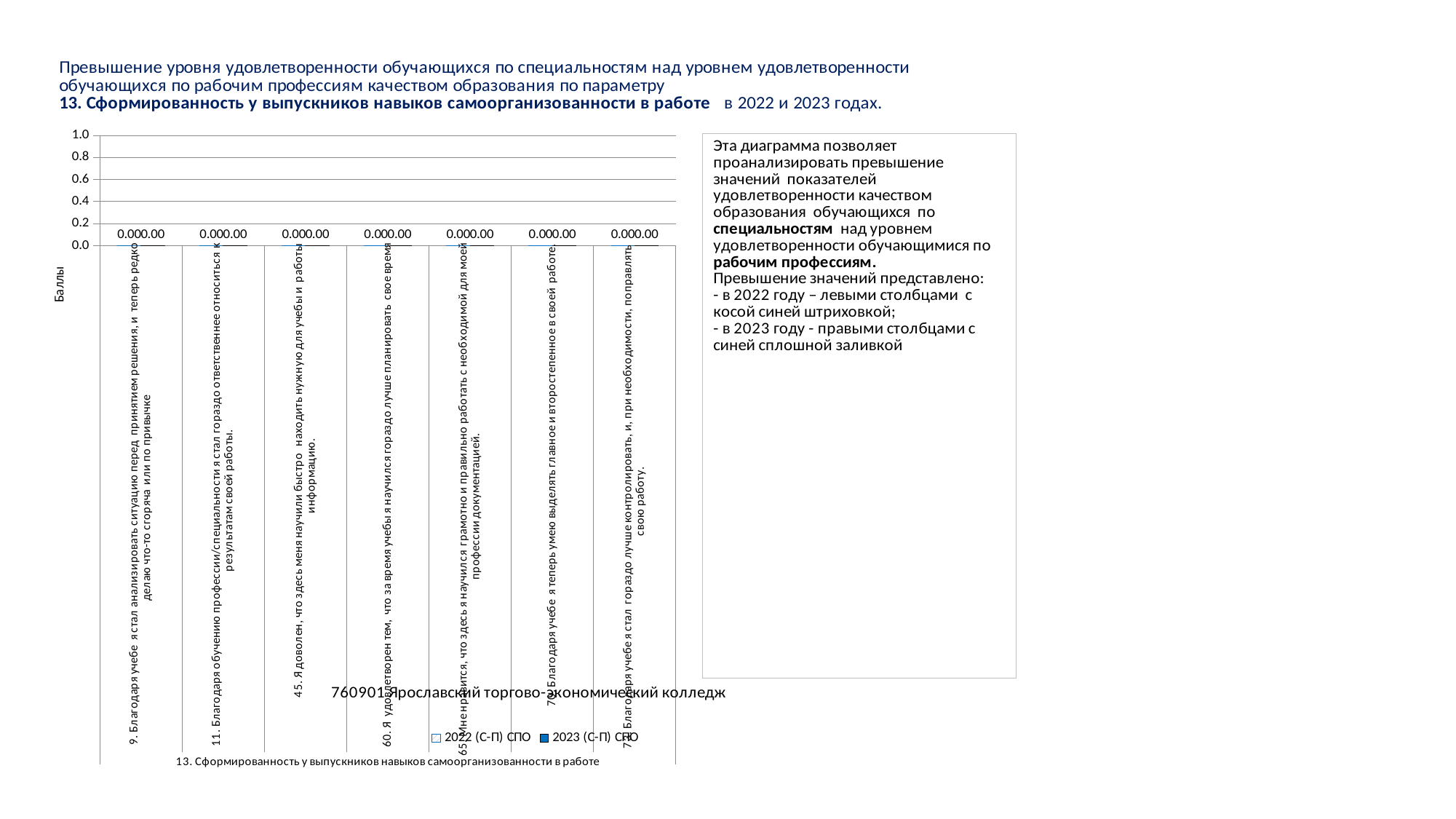
What is the difference between the printed values for category '9.' and category '70.'? 0.00 What value is printed as the data label for the category '60. Я удовлетворен тем, что за время учебы я научился гораздо лучше планировать свое время'? 0.00 What value is printed as the data label for the category '9. Благодаря учебе я стал анализировать ситуацию перед принятием решения...'? 0.00 How many categories are shown along the x axis of the chart? 7 What is the label of the vertical axis of the chart? Баллы Is the value for the category '11. Благодаря обучению профессии/специальности я стал гораздо ответственнее относиться к результатам своей работы.' greater or less than 0.2? less What value is printed as the data label for the category '45. Я доволен, что здесь меня научили быстро находить нужную для учебы и работы информацию.'? 0.00 What are the two series named in the chart legend? 2022 (С-П) СПО and 2023 (С-П) СПО What is the highest tick value shown on the vertical axis of the chart? 1.0 What kind of chart is shown on the slide? bar chart How many series does the chart legend list? 2